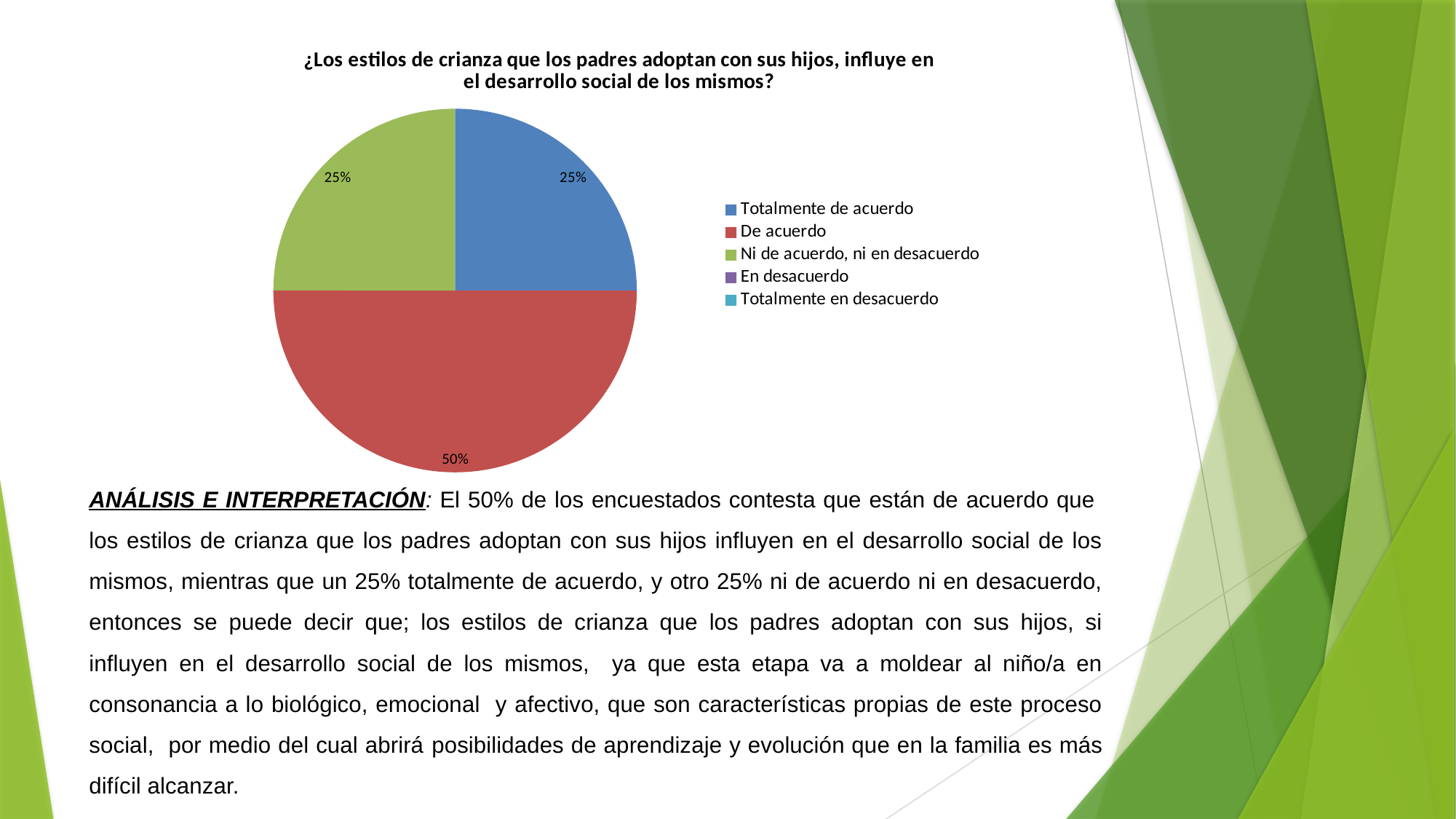
How many entries does the legend list? 5 What share of the pie does the "De acuerdo" slice represent? 50% What percentage of respondents answered "De acuerdo"? 50% How many slices with a printed percentage does the pie chart have? 3 What is the title of the pie chart? ¿Los estilos de crianza que los padres adoptan con sus hijos, influye en el desarrollo social de los mismos? Which response category has the largest share of the pie? De acuerdo What percentage of respondents answered "Totalmente de acuerdo"? 25% What is the difference between the share for "De acuerdo" and the share for "Totalmente de acuerdo"? 25% What kind of chart is shown on the slide? pie chart What colour is the "De acuerdo" slice? red What percentage of respondents answered "Ni de acuerdo, ni en desacuerdo"? 25% Which is larger, the share for "De acuerdo" or the share for "Ni de acuerdo, ni en desacuerdo"? De acuerdo